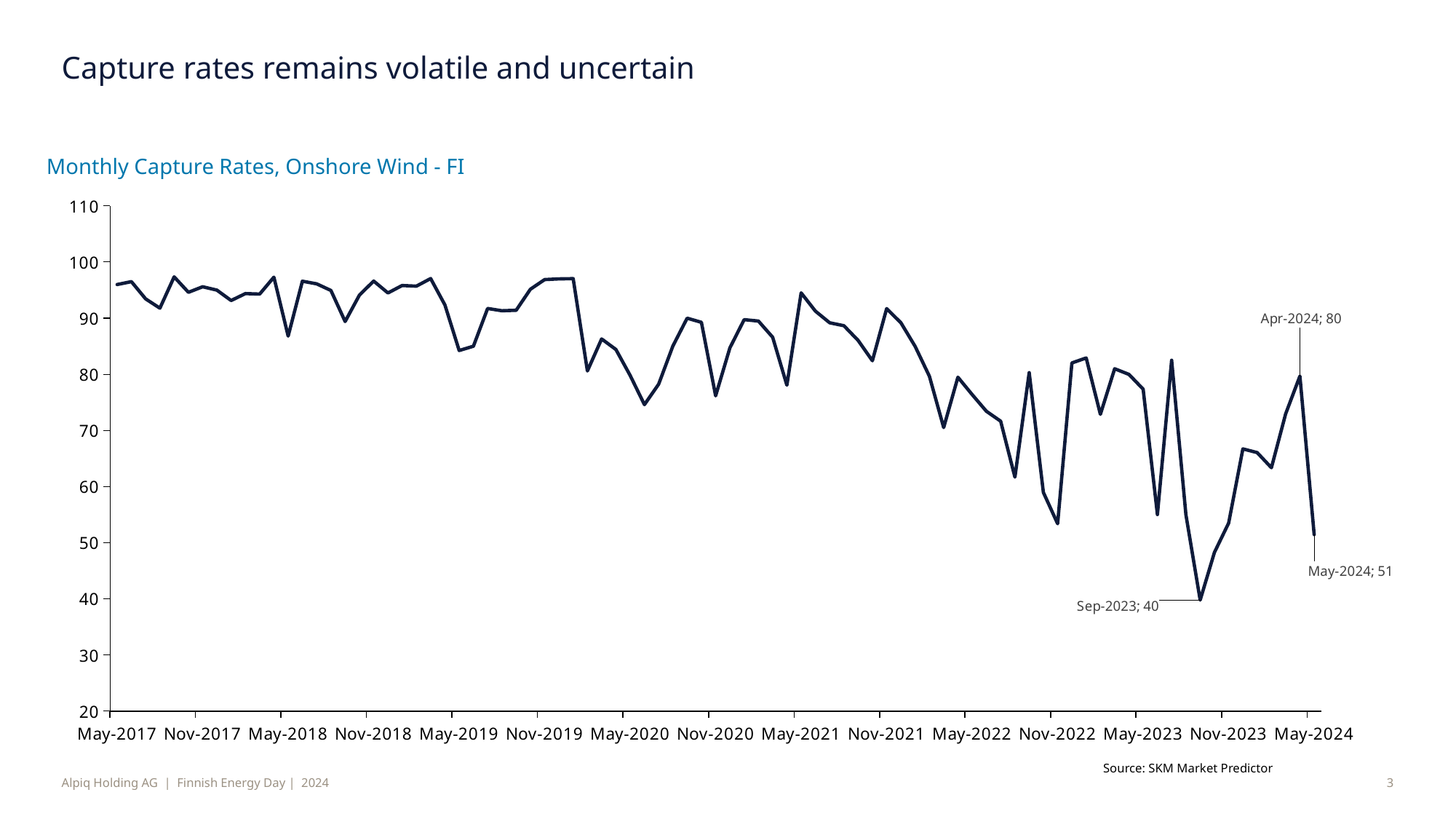
What is the value for May-2024? 51 What is the value for Apr-2024? 80 Do the capture rates generally rise or fall from May-2017 to May-2024? fall Is the value for Nov-2022 greater or less than 70? less What kind of chart is shown on the slide? line chart What is the value for Sep-2023? 40 Which is larger, the value for Apr-2024 or the value for May-2024? Apr-2024 What is the difference between the Apr-2024 value and the Sep-2023 value? 40 What is the difference between the Apr-2024 value and the May-2024 value? 29 What is the title of the chart? Monthly Capture Rates, Onshore Wind - FI Is the value for May-2017 greater or less than 90? greater Which month has the lowest capture rate on the chart? Sep-2023